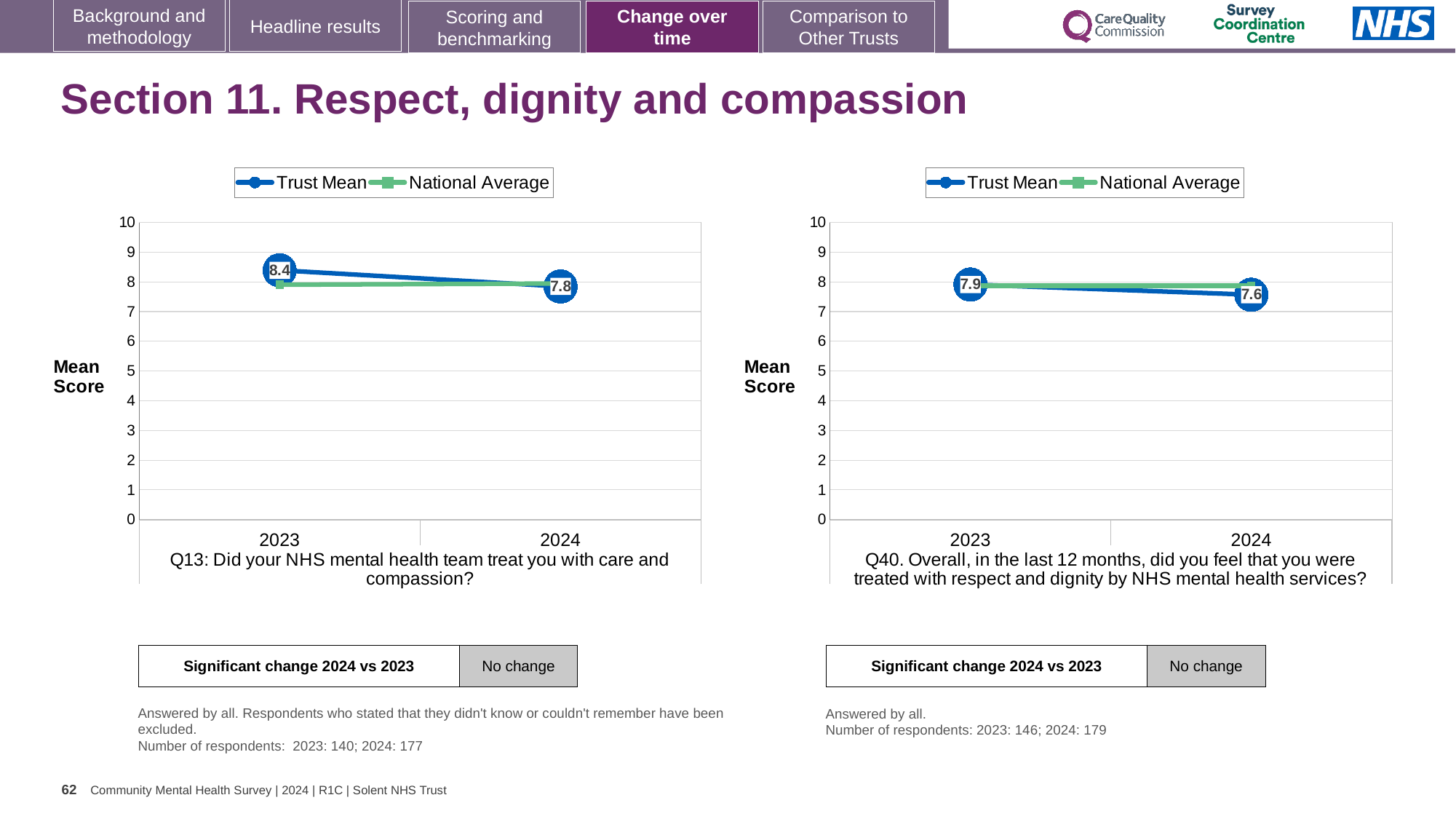
In the Q13 chart (left), what is the Trust Mean for 2024? 7.8 In the Q13 chart (left), does the Trust Mean rise or fall from 2023 to 2024? fall In the Q13 chart (left), by how much did the Trust Mean fall from 2023 to 2024? 0.6 In the Q13 chart (left), what is the Trust Mean for 2023? 8.4 How many series does the legend of the Q40 chart (right) list? 2 In the Q40 chart (right), what is the Trust Mean for 2024? 7.6 In the Q13 chart (left), is the National Average for 2023 greater or less than 5? greater In the Q40 chart (right), which year has the higher Trust Mean, 2023 or 2024? 2023 In the Q40 chart (right), what is the Trust Mean for 2023? 7.9 In the Q40 chart (right), what is the difference between the Trust Mean in 2023 and 2024? 0.3 What kind of chart is the Q13 chart (left)? line chart How many years are shown on the x axis of the Q13 chart (left)? 2